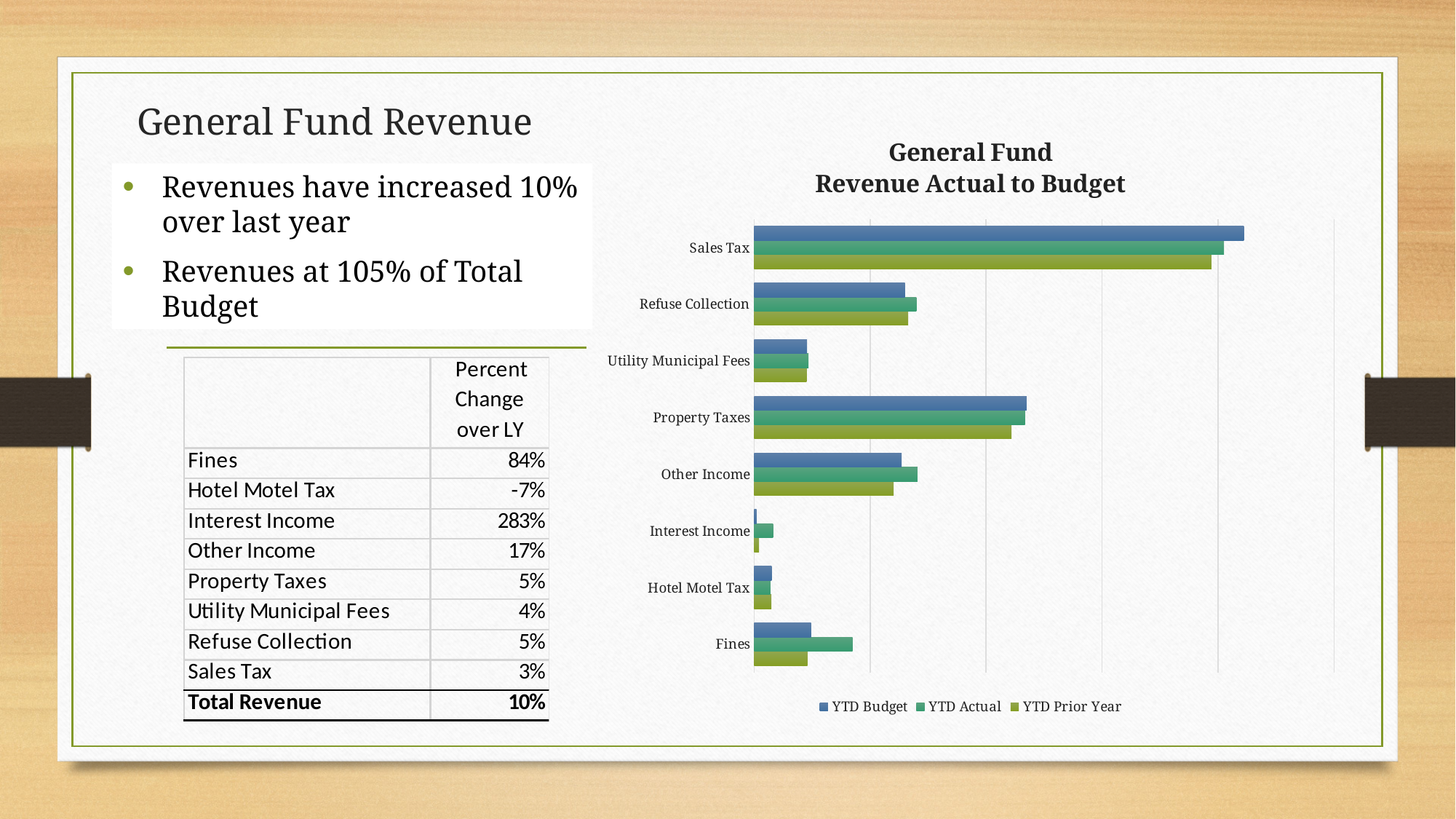
What kind of chart is shown on the slide? Bar chart How many revenue categories are plotted on the chart? 8 Which has the larger YTD Budget value: Property Taxes or Refuse Collection? Property Taxes For Fines, which is larger: YTD Budget or YTD Actual? YTD Actual Which series is shown in the lightest green colour in the legend? YTD Prior Year Which category has the highest YTD Budget value? Sales Tax What is the title of the chart? General Fund Revenue Actual to Budget How many series does the chart's legend list? 3 Which category has the highest YTD Actual value? Sales Tax For Sales Tax, which is larger: YTD Budget or YTD Actual? YTD Budget Which category has the lowest YTD Budget value? Interest Income